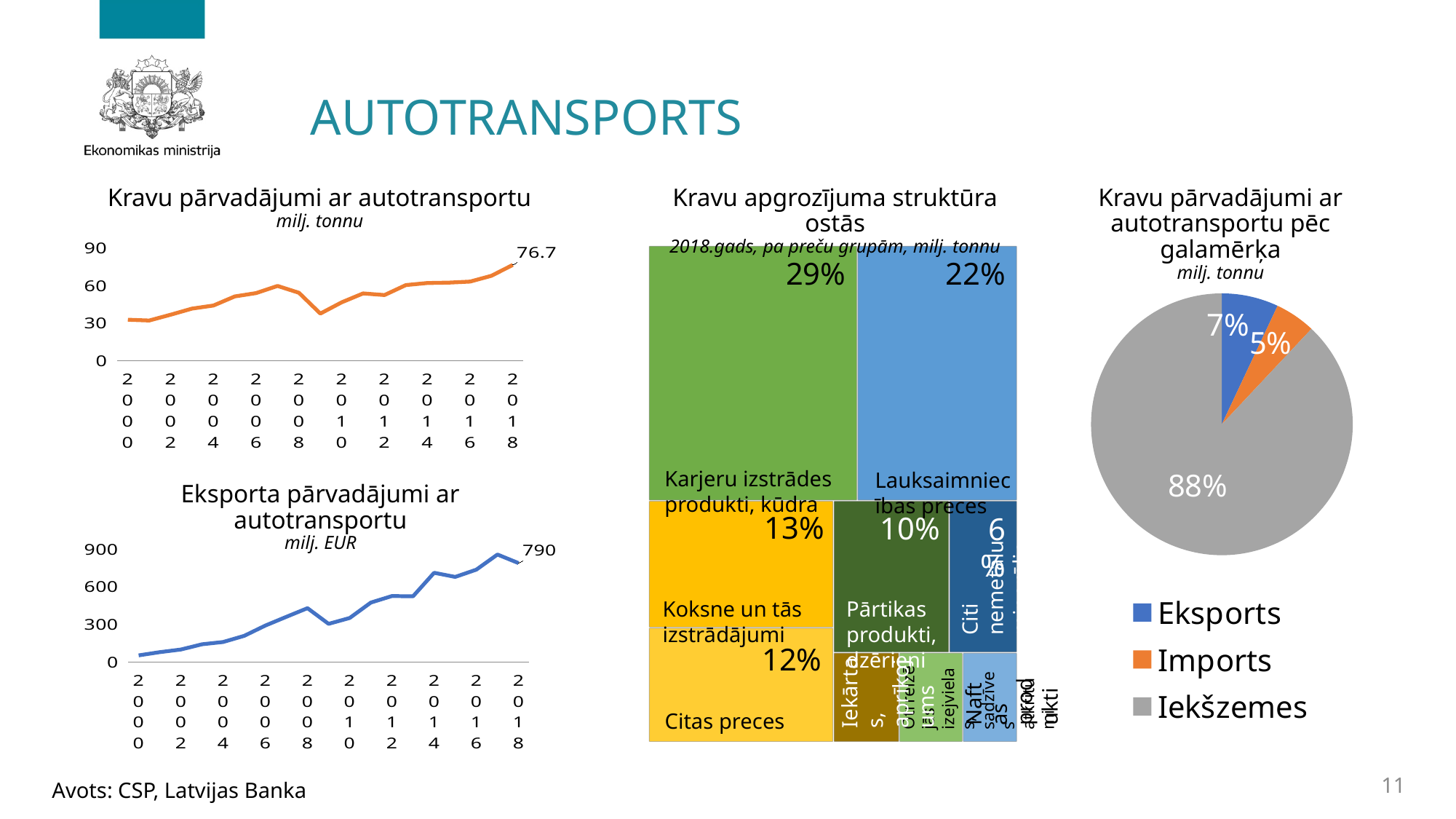
In the chart 'Eksporta pārvadājumi ar autotransportu', what value is labelled for 2018? 790 In the chart 'Kravu pārvadājumi ar autotransportu', do the values generally rise or fall from 2000 to 2018? rise How many entries does the legend of the pie chart 'Kravu pārvadājumi ar autotransportu pēc galamērķa' list? 3 In the pie chart 'Kravu pārvadājumi ar autotransportu pēc galamērķa', what share does 'Iekšzemes' have? 88% In the chart 'Kravu apgrozījuma struktūra ostās', what share is shown for 'Karjeru izstrādes produkti, kūdra'? 29% What kind of chart is 'Eksporta pārvadājumi ar autotransportu'? line chart In the chart 'Kravu pārvadājumi ar autotransportu', what value is labelled for 2018? 76.7 In the chart 'Kravu apgrozījuma struktūra ostās', what share is shown for 'Koksne un tās izstrādājumi'? 13% In the chart 'Eksporta pārvadājumi ar autotransportu', is the value for 2000 greater or less than 300? less In the chart 'Kravu pārvadājumi ar autotransportu', is the value for 2010 greater or less than 60? less In the pie chart 'Kravu pārvadājumi ar autotransportu pēc galamērķa', which category has the smallest share? Imports In the chart 'Kravu apgrozījuma struktūra ostās', which is larger: 'Lauksaimniecības preces' or 'Citas preces'? Lauksaimniecības preces